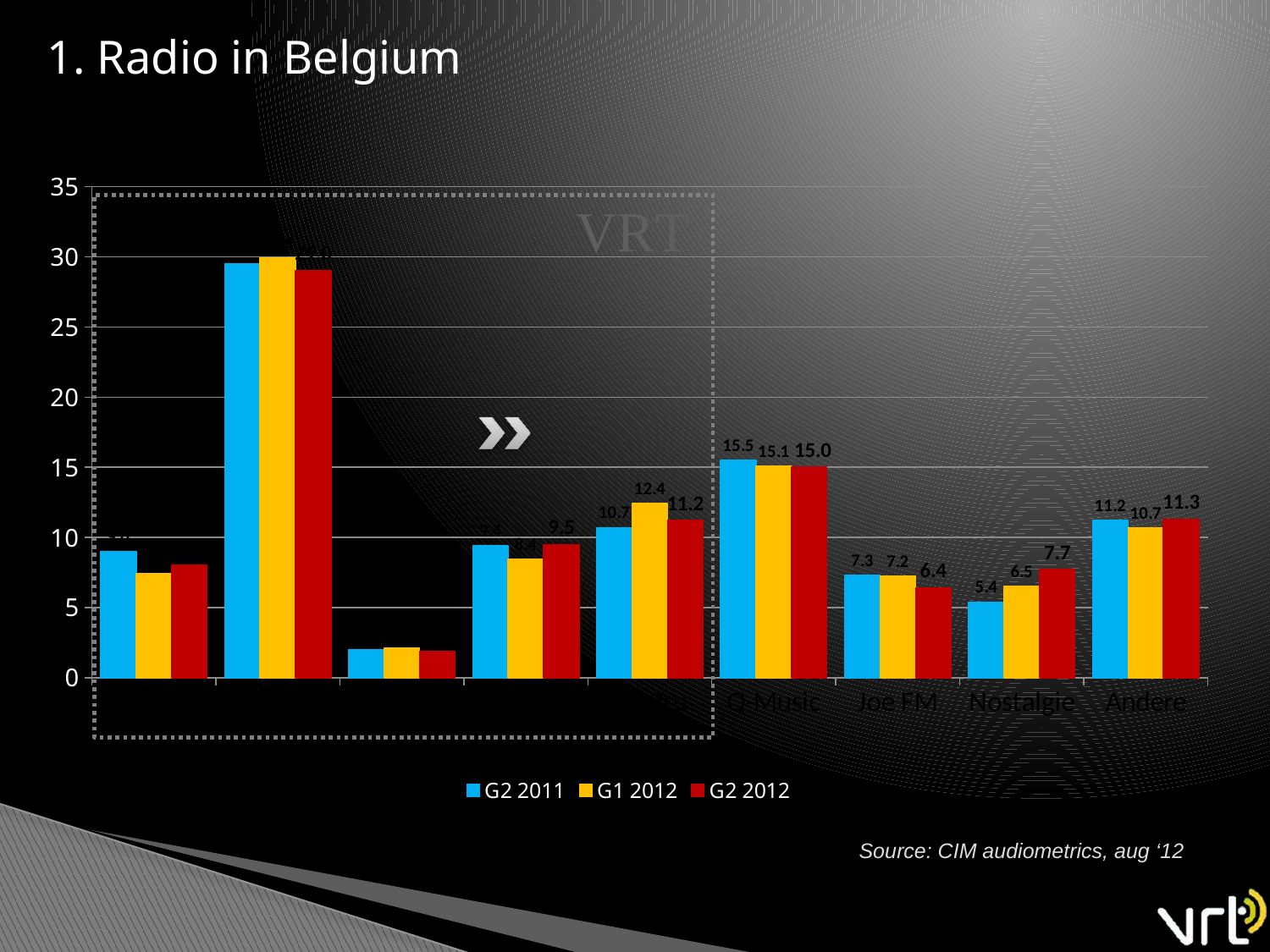
What kind of chart is shown on the slide? bar chart Which is larger for Joe FM, the G2 2011 value or the G2 2012 value? G2 2011 What is the G2 2011 value for Q-Music? 15.5 What is the G1 2012 value for Andere? 10.7 What is the G2 2012 value for Joe FM? 6.4 What is the source cited below the chart? CIM audiometrics, aug '12 How many series does the legend list? 3 What is the difference between the G2 2012 and G2 2011 values for Nostalgie? 2.3 Do the values for Nostalgie rise or fall from G2 2011 to G2 2012? rise What is the G2 2012 value for Nostalgie? 7.7 Is the G2 2012 value for Q-Music greater or less than 10? greater Which series is shown in red in the legend? G2 2012